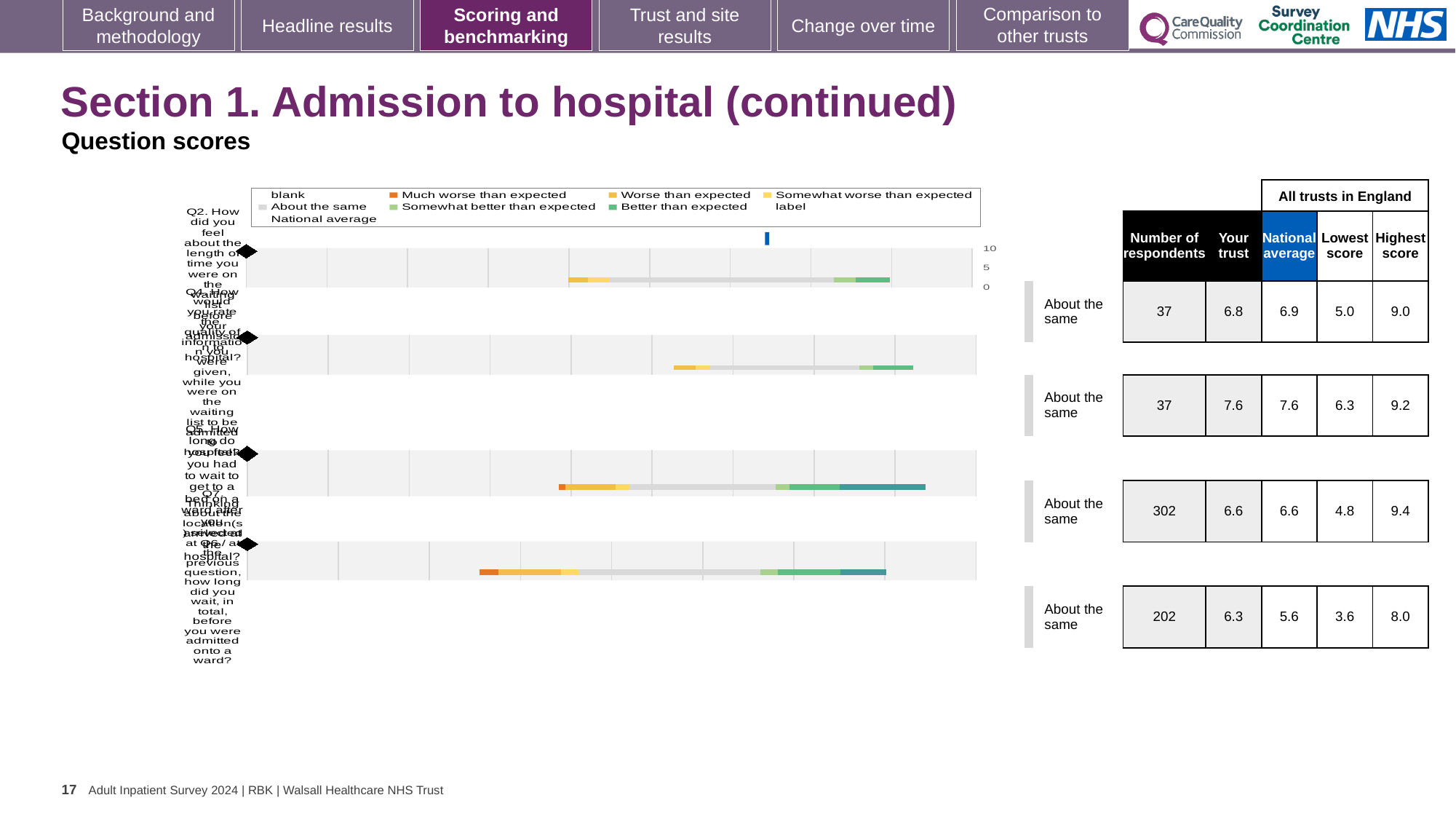
What benchmark category is shown for every question row in the chart? About the same Which question row has the highest number of respondents in the table beside the chart? the third row (302) In the table beside the chart, what is the 'Your trust' score for the first question row? 6.8 In the table beside the chart, what is the number of respondents for the third question row? 302 For the fourth question row, what is the difference between the highest score and the lowest score in the table? 4.4 Which question row has the lowest 'Lowest score' value in the table beside the chart? the fourth row (3.6) For the fourth question row, which is larger: the 'Your trust' score or the national average? Your trust (6.3) In the table beside the chart, what is the national average for the fourth question row? 5.6 What kind of chart is shown on the slide? bar chart What is the highest score for the third question row in the table beside the chart? 9.4 How many question rows are plotted in the chart? 4 Which question row has the highest 'Your trust' score in the table beside the chart? the second row (7.6)